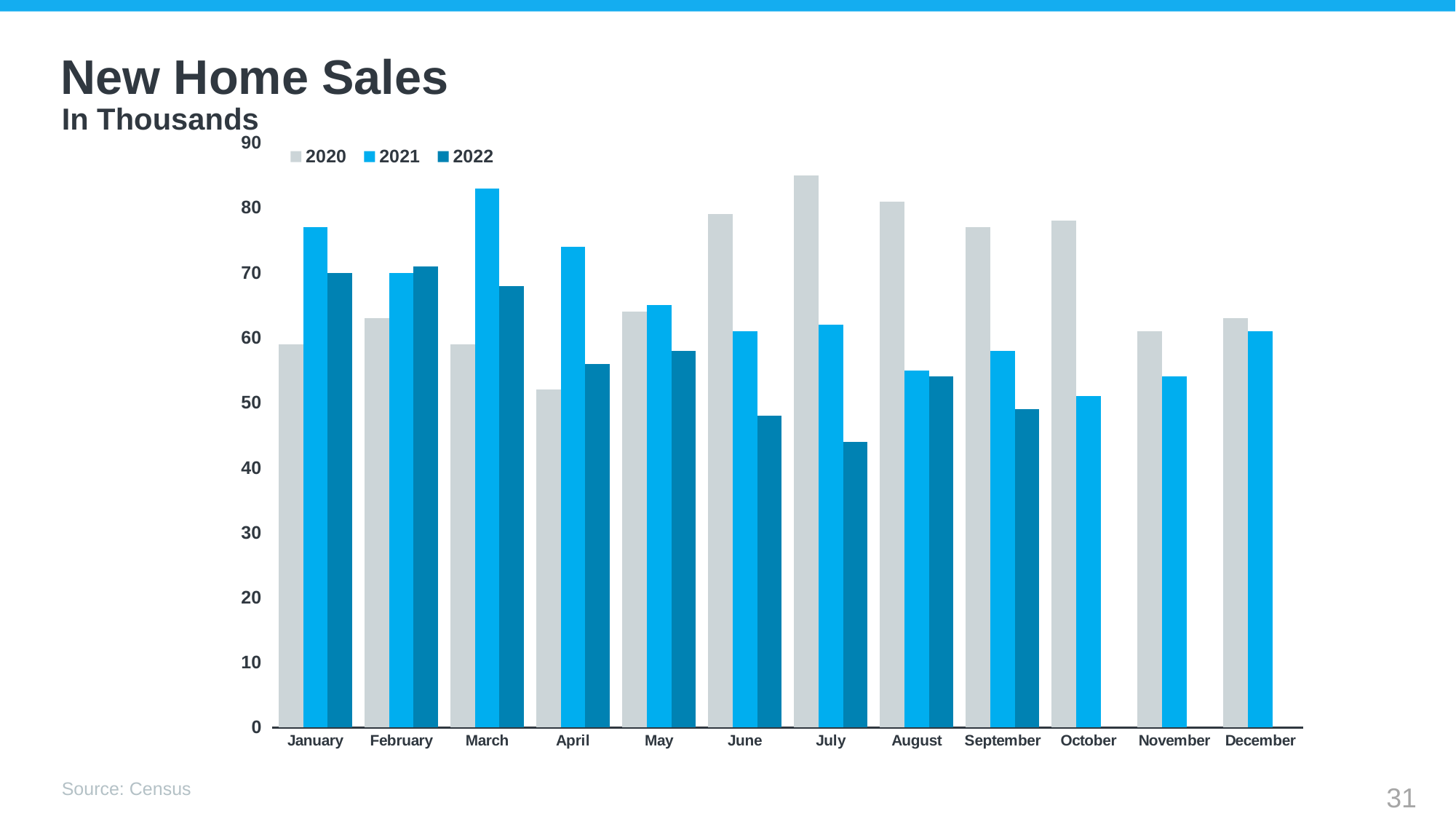
For how many months is a 2022 bar shown? 9 In July, which series has the larger value, 2020 or 2021? 2020 In January, which series has the larger value, 2020 or 2021? 2021 In which month is the 2021 value highest? March What type of chart is shown on the slide? bar chart In which month is the 2020 value lowest? April How many series does the legend list? 3 In which month is the 2022 value lowest? July Is the 2020 value for July greater or less than 80? greater Is the 2022 value for July greater or less than 50? less How many months are shown on the x axis? 12 In which month is the 2020 value highest? July